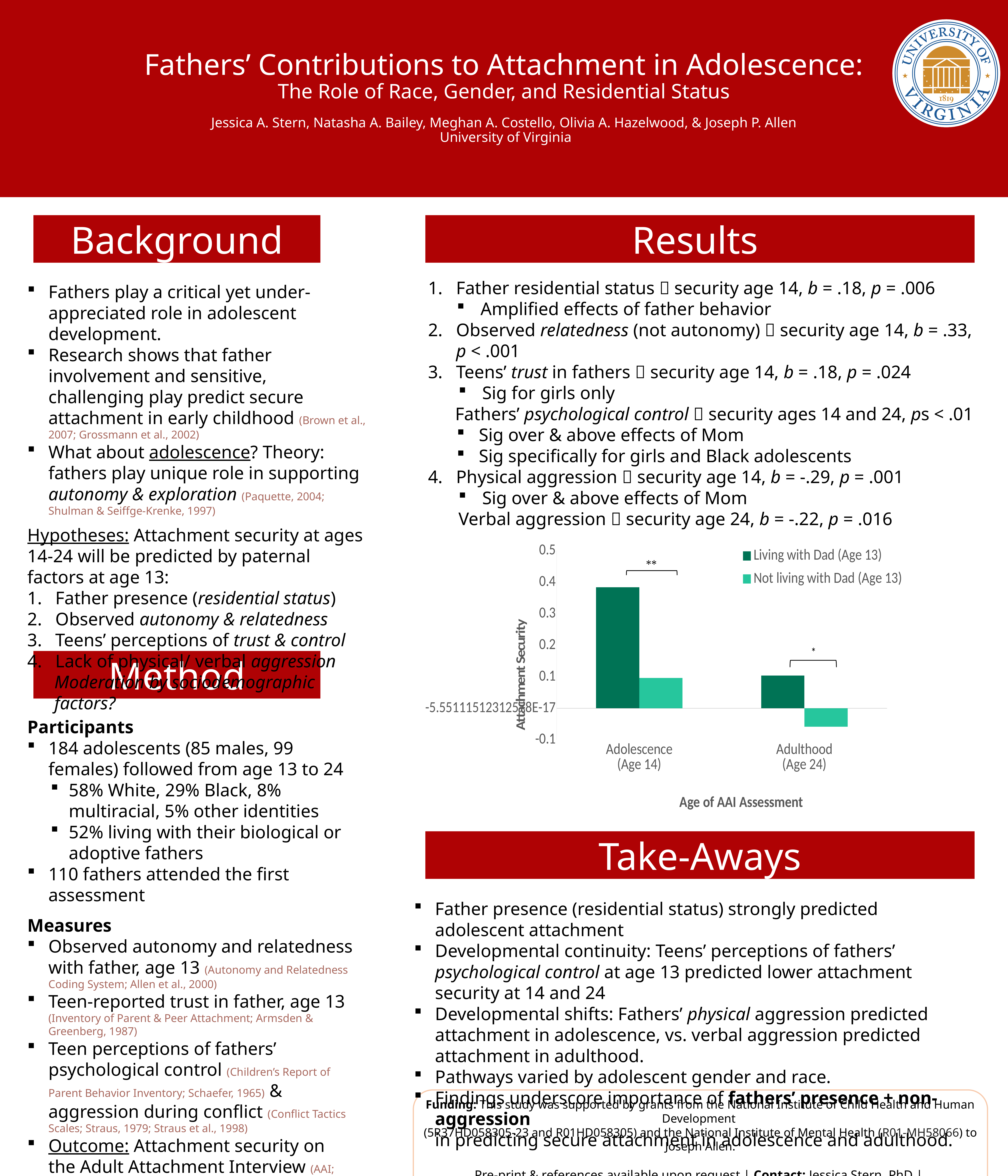
Does the Living with Dad (Age 13) series rise or fall from Adolescence (Age 14) to Adulthood (Age 24)? fall What is the title of the chart's y axis? Attachment Security How many series does the chart legend list? 2 What is the title of the chart's x axis? Age of AAI Assessment Which series has the highest bar in the chart? Living with Dad (Age 13) Is the value for Living with Dad (Age 13) at Adulthood (Age 24) greater or less than 0.2? less Is the value for Living with Dad (Age 13) at Adolescence (Age 14) greater or less than 0.3? greater Is the value for Not living with Dad (Age 13) at Adolescence (Age 14) greater or less than 0.2? less At Adolescence (Age 14), which is larger: Living with Dad (Age 13) or Not living with Dad (Age 13)? Living with Dad (Age 13) Which bar in the chart is the lowest? Not living with Dad (Age 13) at Adulthood (Age 24) How many categories are shown on the x axis of the chart? 2 What kind of chart is shown in the Results section? bar chart